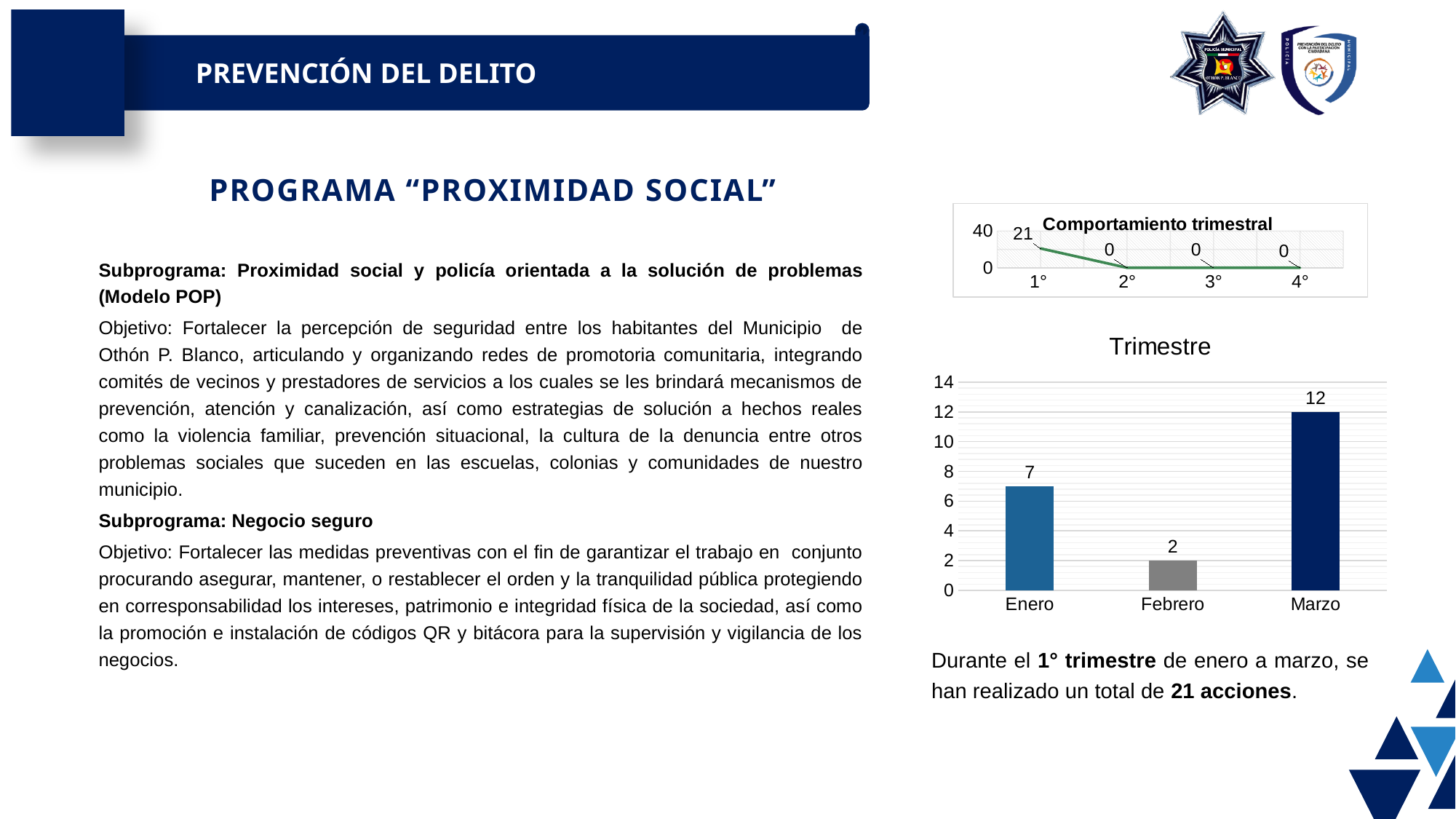
What kind of chart is the "Comportamiento trimestral" chart? line chart In the "Trimestre" chart, which month has the highest value? Marzo In the "Trimestre" chart, which is larger, the value for Enero or the value for Febrero? Enero In the "Trimestre" chart, what is the value for Marzo? 12 What kind of chart is the "Trimestre" chart? bar chart In the "Trimestre" chart, what is the difference between the values for Marzo and Enero? 5 In the "Trimestre" chart, which month has the lowest value? Febrero In the "Comportamiento trimestral" chart, what is the value for 3°? 0 How many categories are shown in the "Trimestre" chart? 3 In the "Trimestre" chart, what is the value for Febrero? 2 In the "Trimestre" chart, what is the value for Enero? 7 In the "Comportamiento trimestral" chart, what is the value for 1°? 21